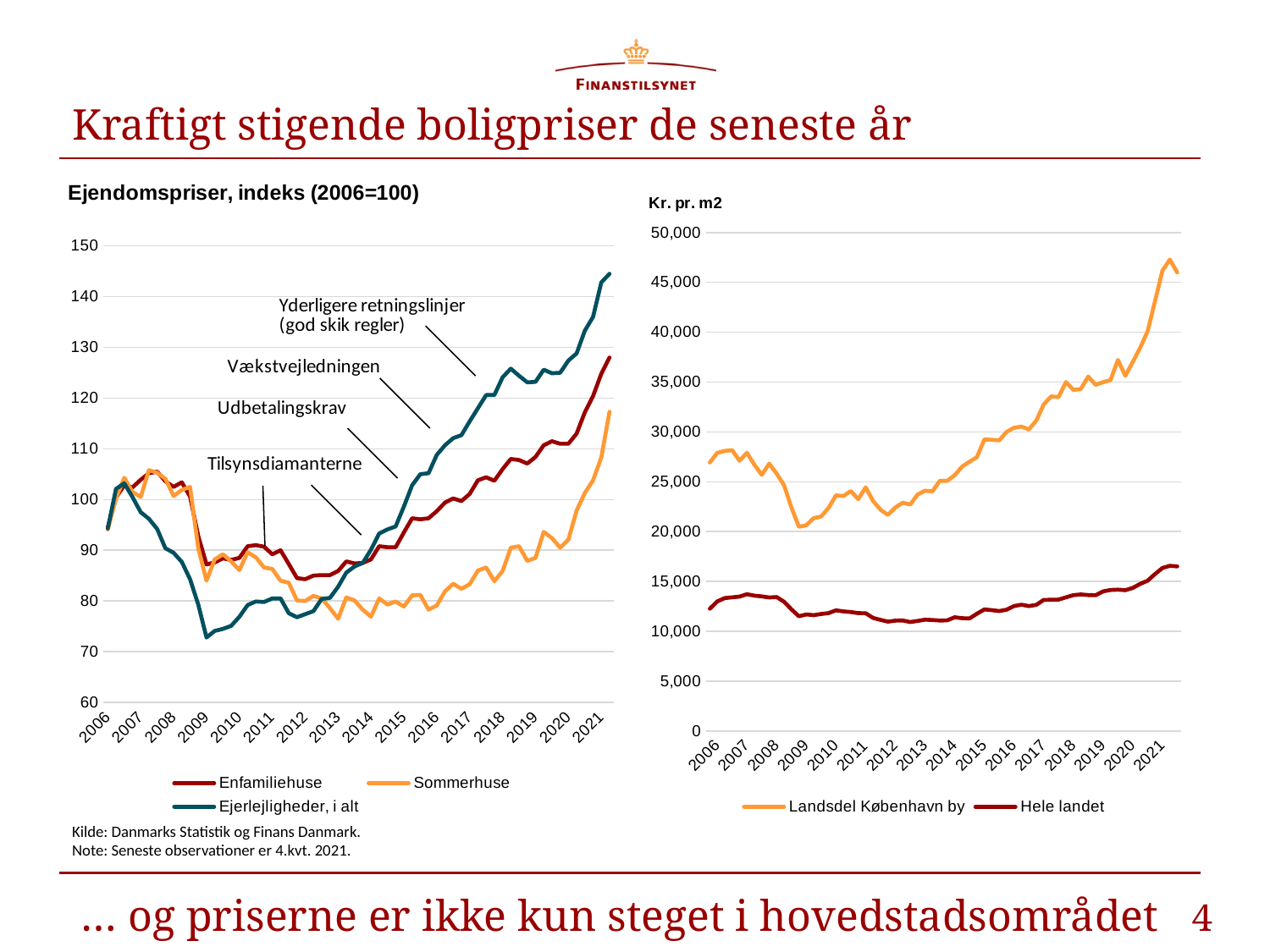
In the right chart 'Kr. pr. m2', which series is higher throughout the period: Landsdel København by or Hele landet? Landsdel København by What kind of chart is the left chart titled 'Ejendomspriser, indeks (2006=100)'? line chart In the left chart 'Ejendomspriser, indeks (2006=100)', is the value for Sommerhuse at the end of 2021 greater or less than 120? less How many series does the legend of the right chart 'Kr. pr. m2' list? 2 In the right chart 'Kr. pr. m2', is the value for Hele landet at the end of 2021 greater or less than 15,000? greater In the right chart 'Kr. pr. m2', is the value for Landsdel København by at the end of 2021 greater or less than 45,000? greater In the left chart 'Ejendomspriser, indeks (2006=100)', which series is higher at the end of 2021: Ejerlejligheder, i alt or Sommerhuse? Ejerlejligheder, i alt What is the title of the left chart? Ejendomspriser, indeks (2006=100) How many series does the legend of the left chart 'Ejendomspriser, indeks (2006=100)' list? 3 In the right chart 'Kr. pr. m2', do the values for Landsdel København by rise or fall from 2012 to 2021? rise